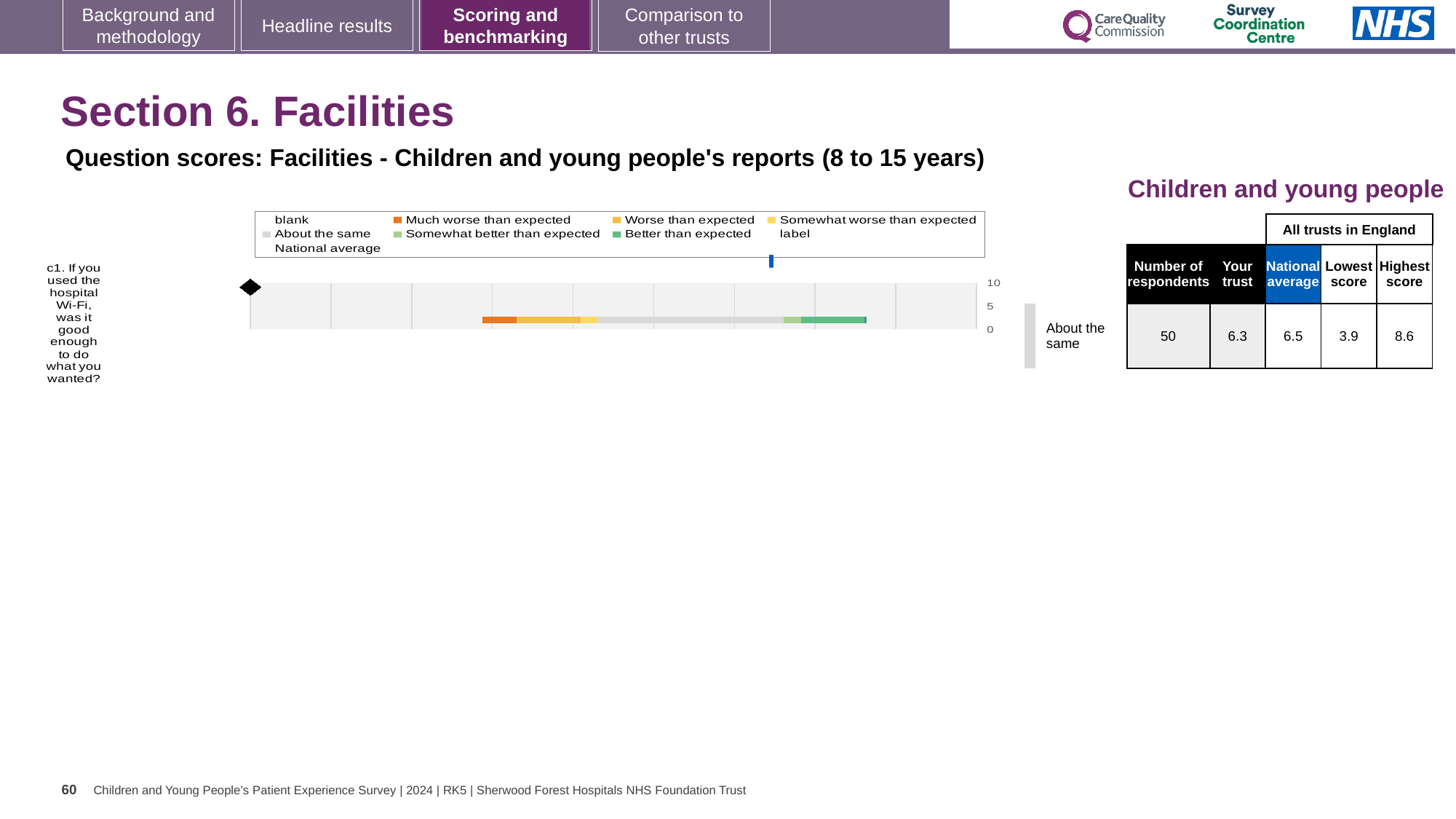
How many respondents answered question c1 about the hospital Wi-Fi? 50 For question c1, which is larger: the 'Your trust' score or the national average? National average What benchmark category is the trust's result for question c1 placed in? About the same By how much does the national average exceed the 'Your trust' score for question c1? 0.2 What is the maximum value shown on the score axis of the Facilities chart? 10 What kind of chart is used to show the question scores for Facilities? bar chart What is the lowest score among all trusts in England for question c1? 3.9 What is the highest score among all trusts in England for question c1? 8.6 What is the 'Your trust' score for question c1 about the hospital Wi-Fi? 6.3 How many survey questions are plotted in the Facilities chart? 1 What is the difference between the highest score and the lowest score for question c1? 4.7 What is the national average score for question c1 about the hospital Wi-Fi? 6.5